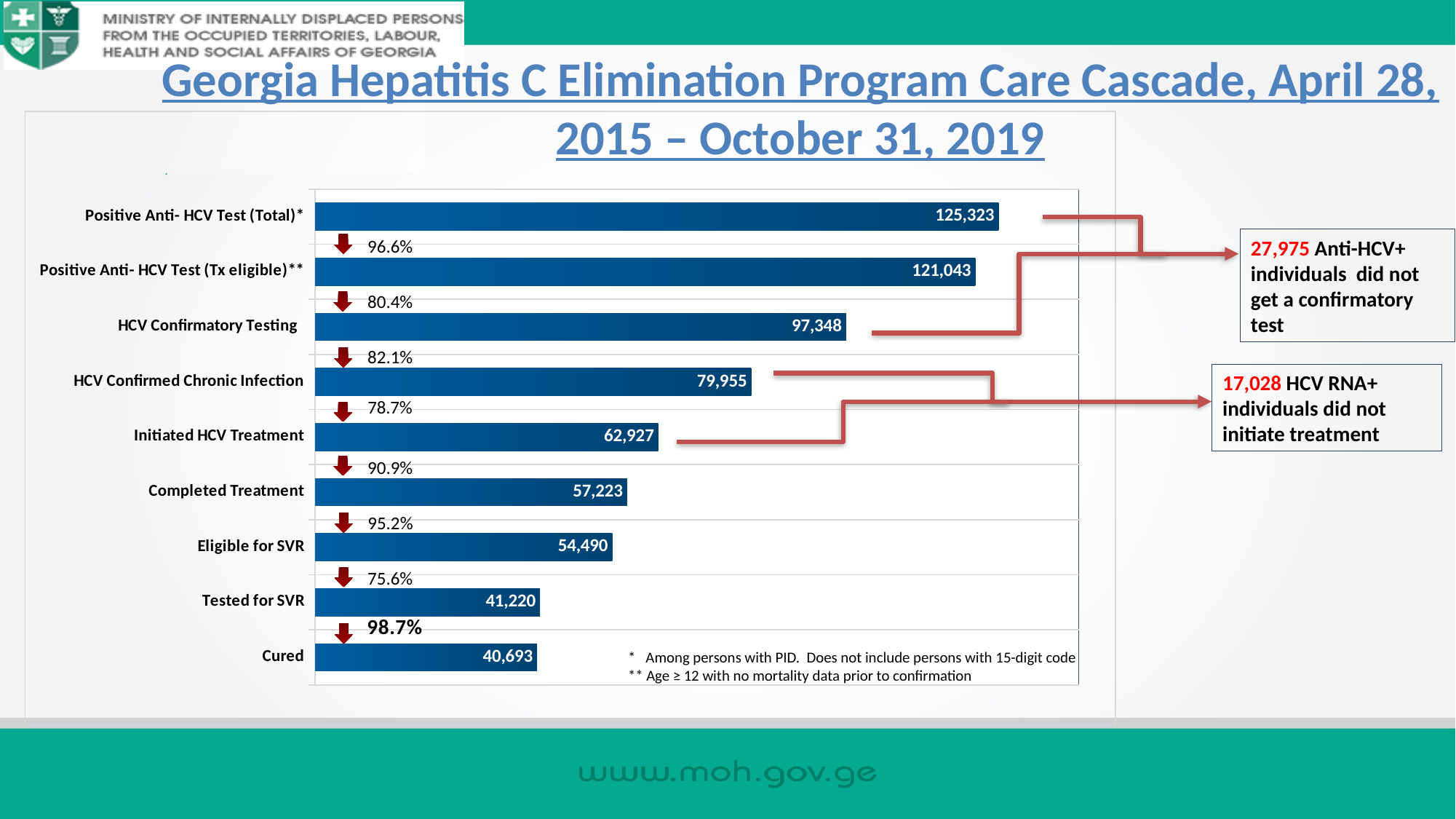
How many categories are shown in the chart? 9 What kind of chart is shown on the slide? Bar chart What is the value for Positive Anti- HCV Test (Total)*? 125,323 What is the difference between Completed Treatment and Eligible for SVR? 2,733 What is the value for Cured? 40,693 What percentage is shown between Tested for SVR and Cured? 98.7% What is the value for HCV Confirmatory Testing? 97,348 Which category has the highest value? Positive Anti- HCV Test (Total)* Which is larger, Tested for SVR or Eligible for SVR? Eligible for SVR What is the value for Initiated HCV Treatment? 62,927 What is the difference between HCV Confirmed Chronic Infection and Initiated HCV Treatment? 17,028 Which category has the lowest value? Cured